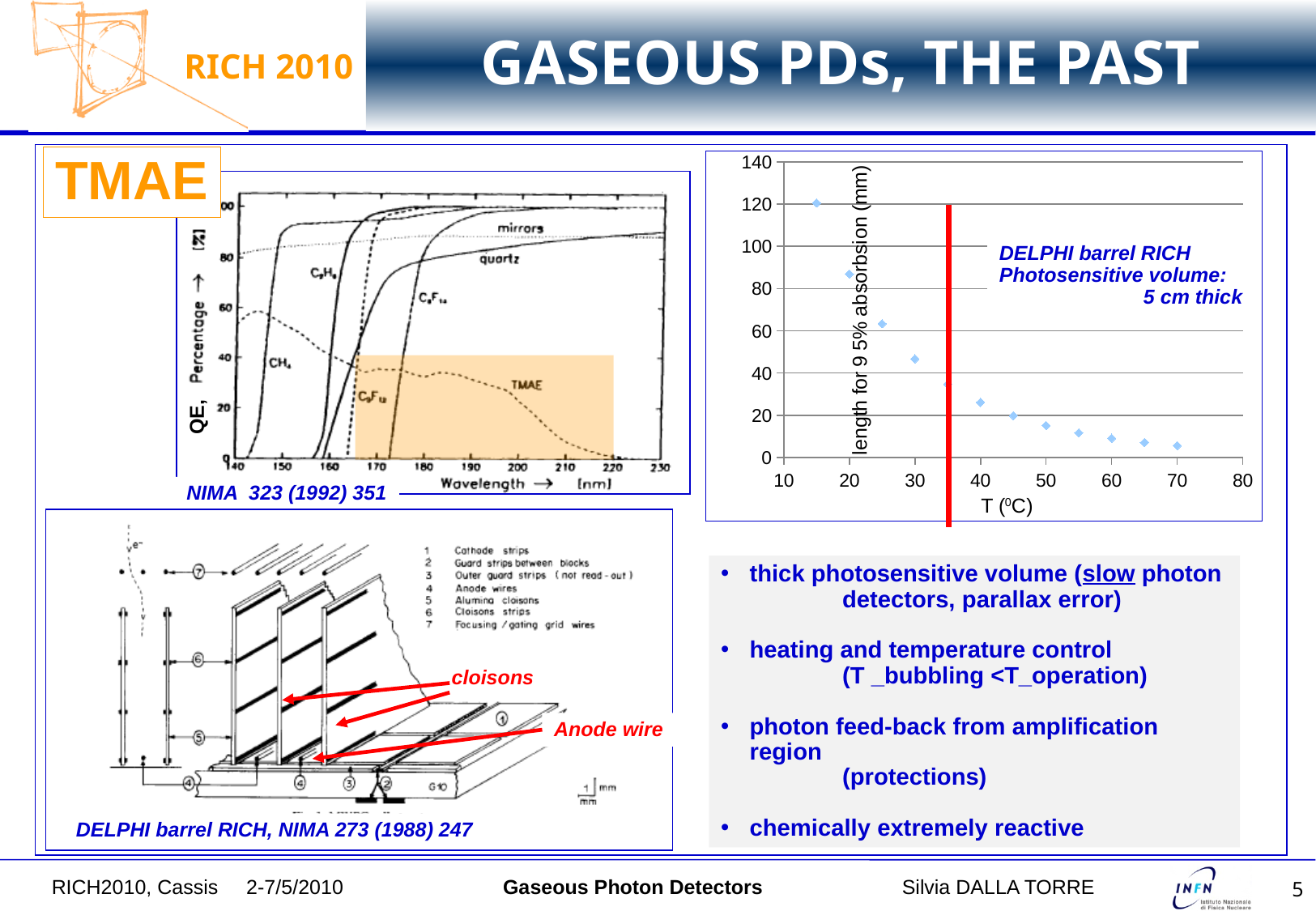
On the chart at the top right, is the value at T = 15 °C greater or less than 100? greater On the chart at the top right, is the value at T = 20 °C greater or less than 80? greater On the chart at the top right, does the length for 95% absorption rise or fall as temperature increases? fall On the chart at the top right, at which plotted temperature is the length for 95% absorption highest? 15 °C On the chart at the top right, which has the larger value: T = 15 °C or T = 70 °C? T = 15 °C On the chart at the top right, is the value at T = 40 °C greater or less than 40? less On the QE chart at the top left, what quantity is plotted on the x axis? Wavelength [nm] On the chart at the top right, what thickness does the annotation give for the DELPHI barrel RICH photosensitive volume? 5 cm thick On the chart at the top right, what kind of chart is used to show length for 95% absorption against temperature? scatter chart On the chart at the top right, what is the label of the x axis? T (°C)